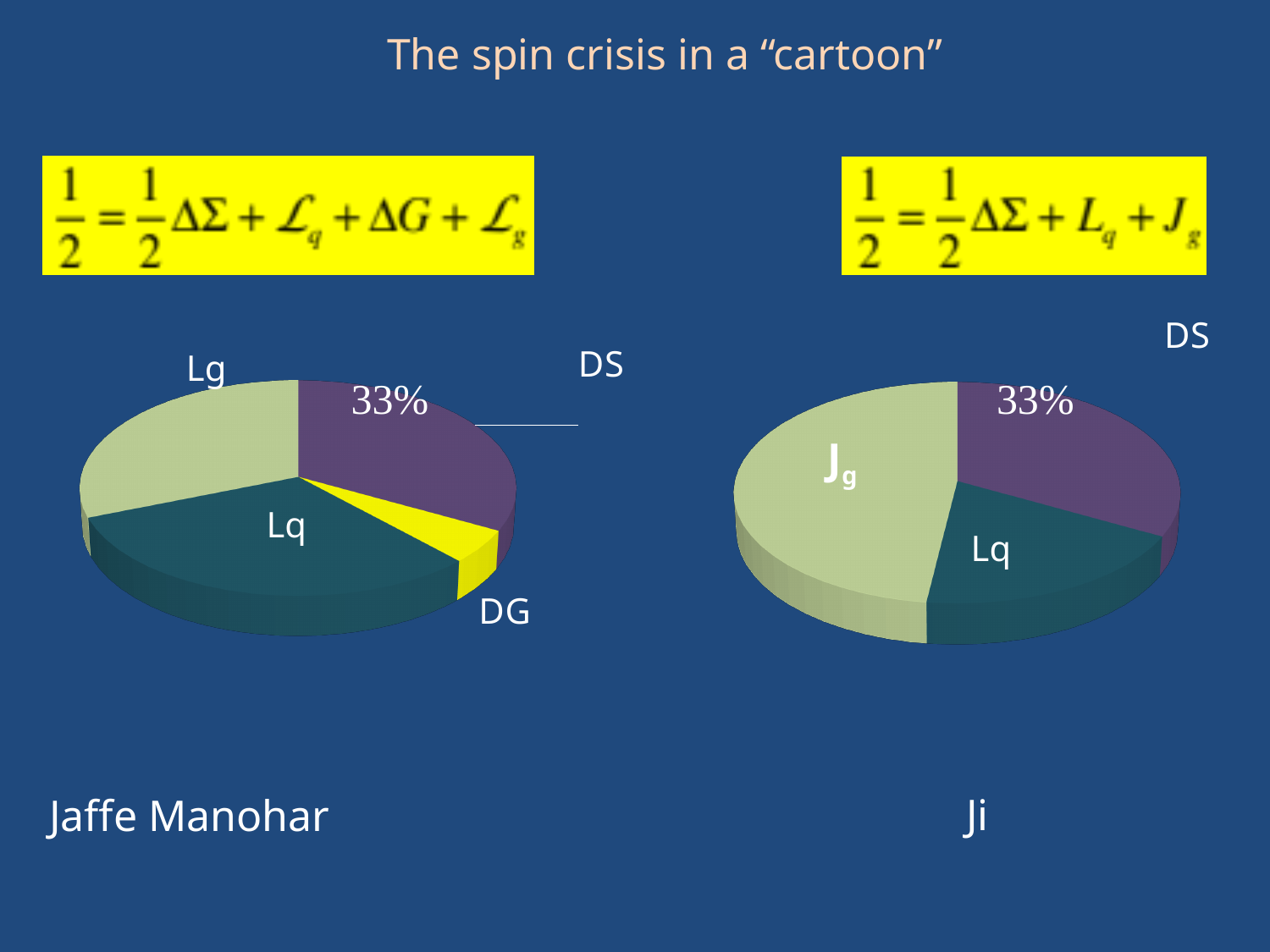
What kind of chart is the left chart labelled Jaffe Manohar? pie chart In the left pie chart (Jaffe Manohar), what share does the DS slice have? 33% What kind of chart is the right chart labelled Ji? pie chart Which slice label appears in the left pie chart (Jaffe Manohar) but not in the right pie chart (Ji)? DG and Lg In the right pie chart (Ji), how many slices are there? 3 In the right pie chart (Ji), which slice is the smallest? Lq In the right pie chart (Ji), which slice is the largest? Jg In the left pie chart (Jaffe Manohar), how many slices are there? 4 In the right pie chart (Ji), which slice is larger, Jg or Lq? Jg In the right pie chart (Ji), what share does the DS slice have? 33% In the left pie chart (Jaffe Manohar), which slice is the smallest? DG In the left pie chart (Jaffe Manohar), which slice is larger, Lq or DG? Lq